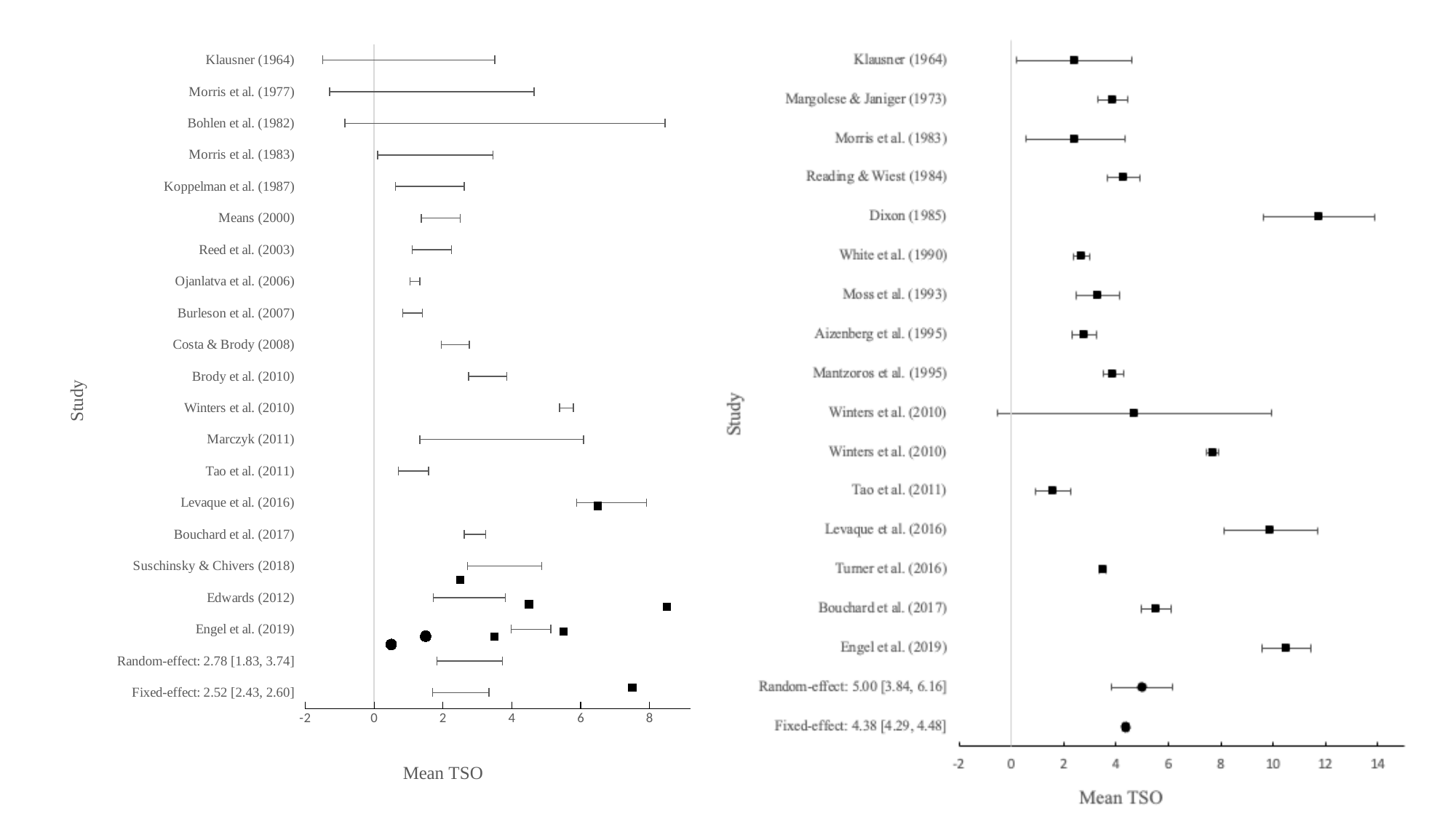
What is the label of the x axis on the right chart? Mean TSO On the right chart, is the mean TSO for Dixon (1985) greater or less than 10? greater On the right chart, which study has the lowest mean TSO? Tao et al. (2011) On the left chart, what is the fixed-effect pooled estimate of mean TSO? 2.52 On the right chart, which has the larger mean TSO: Engel et al. (2019) or Bouchard et al. (2017)? Engel et al. (2019) On the right chart, which study has the highest mean TSO? Dixon (1985) On the right chart, is the mean TSO for Tao et al. (2011) greater or less than 2? less On the right chart, what is the fixed-effect pooled estimate of mean TSO? 4.38 On the right chart, what is the difference between the random-effect estimate and the fixed-effect estimate? 0.62 On the left chart, what is the random-effect pooled estimate of mean TSO? 2.78 On the right chart, what is the random-effect pooled estimate of mean TSO? 5.00 On the right chart, is the mean TSO for Turner et al. (2016) greater or less than 4? less